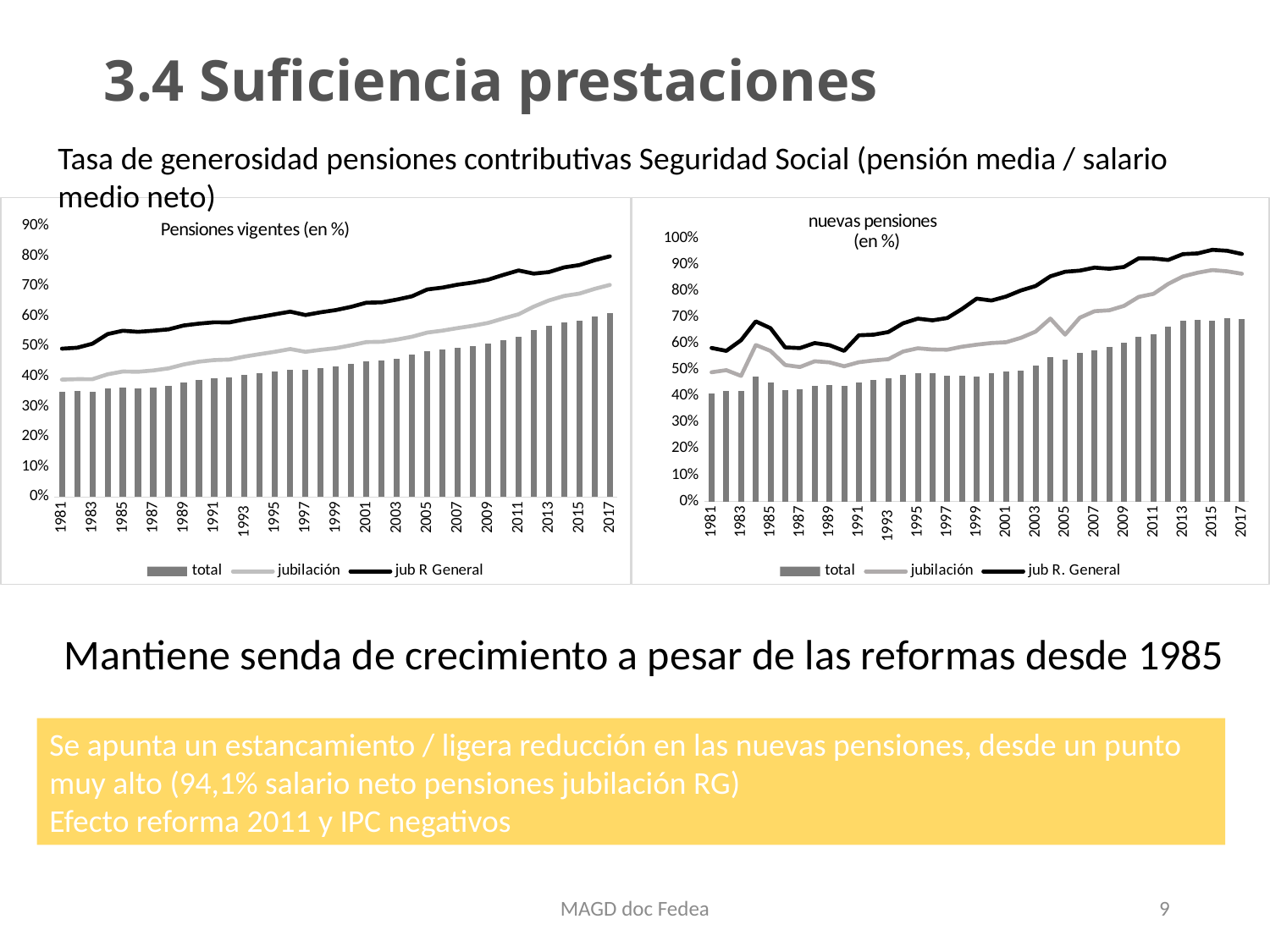
In the chart titled 'Pensiones vigentes (en %)', how many series does the legend list? 3 In the chart titled 'Pensiones vigentes (en %)', is the 'total' value for 1981 greater or less than 40%? less What kind of chart is the left chart, 'Pensiones vigentes (en %)'? Combined bar and line chart In the chart titled 'nuevas pensiones (en %)', does the 'total' series generally rise or fall from 1981 to 2017? Rises In the chart titled 'nuevas pensiones (en %)', is the 'jub R. General' value for 2017 greater or less than 80%? greater What is the first year and the last year shown on the x axis of the chart titled 'nuevas pensiones (en %)'? 1981 and 2017 In the chart titled 'Pensiones vigentes (en %)', does the 'jub R General' line rise or fall from 1981 to 2017? Rises In the chart titled 'Pensiones vigentes (en %)', which is larger in 2017: 'total' or 'jub R General'? jub R General In the chart titled 'nuevas pensiones (en %)', is the 'total' value for 1981 greater or less than 50%? less In the chart titled 'Pensiones vigentes (en %)', which series has the highest values throughout the period? jub R General In the chart titled 'nuevas pensiones (en %)', what are the three legend entries? total, jubilación, jub R. General